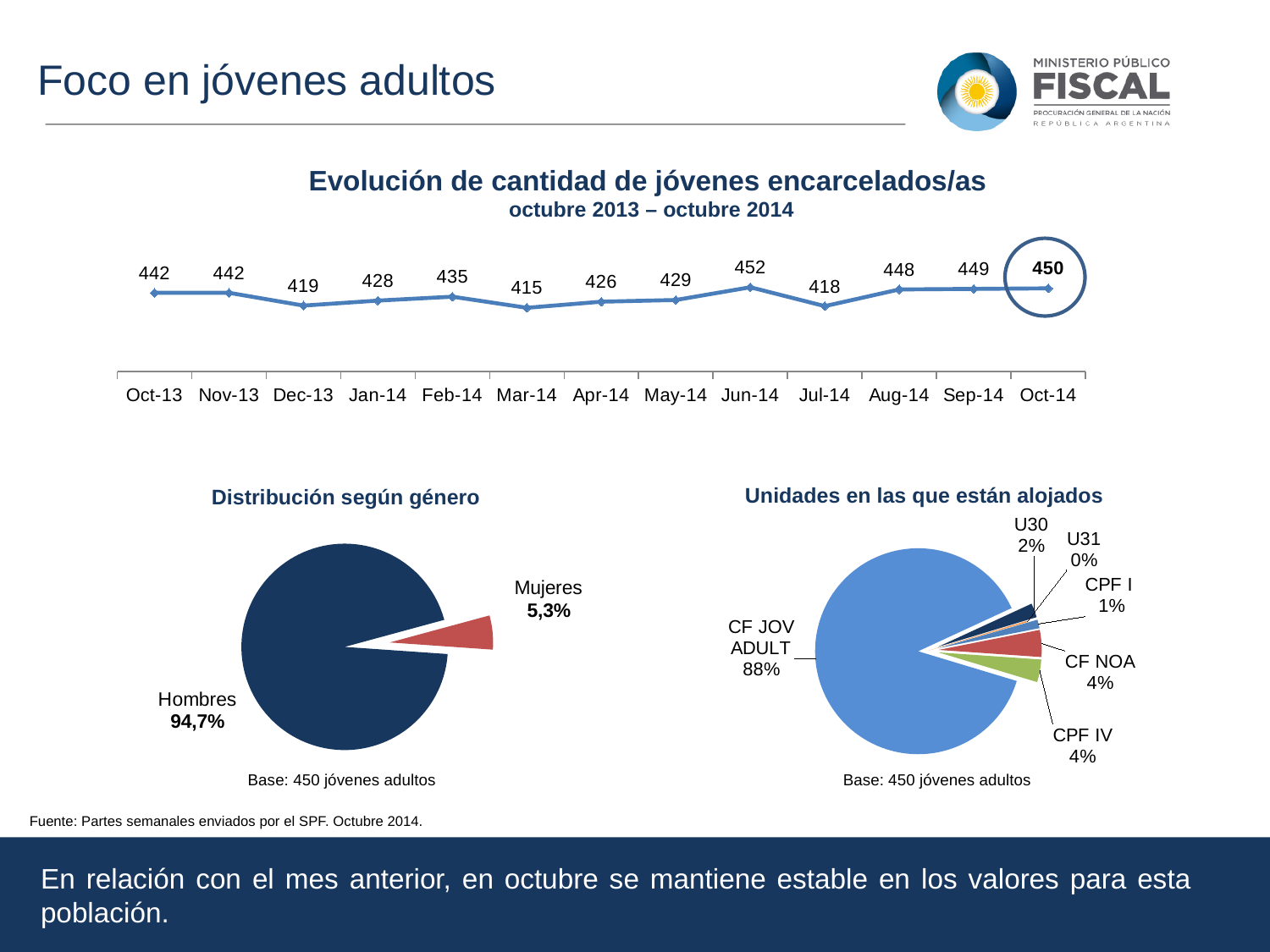
In the chart 'Evolución de cantidad de jóvenes encarcelados/as', what is the value for Mar-14? 415 In the chart 'Unidades en las que están alojados', what share is CF JOV ADULT? 88% In the chart 'Unidades en las que están alojados', how many units (slices) are labelled? 6 In the chart 'Evolución de cantidad de jóvenes encarcelados/as', which month has the lowest value? Mar-14 In the chart 'Evolución de cantidad de jóvenes encarcelados/as', what is the difference between the values for Jun-14 and Jul-14? 34 In the chart 'Evolución de cantidad de jóvenes encarcelados/as', how many months are plotted? 13 What kind of chart is 'Evolución de cantidad de jóvenes encarcelados/as'? Line chart In the chart 'Evolución de cantidad de jóvenes encarcelados/as', what is the value for Oct-14? 450 In the chart 'Evolución de cantidad de jóvenes encarcelados/as', is the value for Dec-13 larger or smaller than the value for Nov-13? Smaller In the chart 'Distribución según género', what share is Hombres? 94,7% In the chart 'Distribución según género', what share is Mujeres? 5,3% In the chart 'Evolución de cantidad de jóvenes encarcelados/as', which month has the highest value? Jun-14